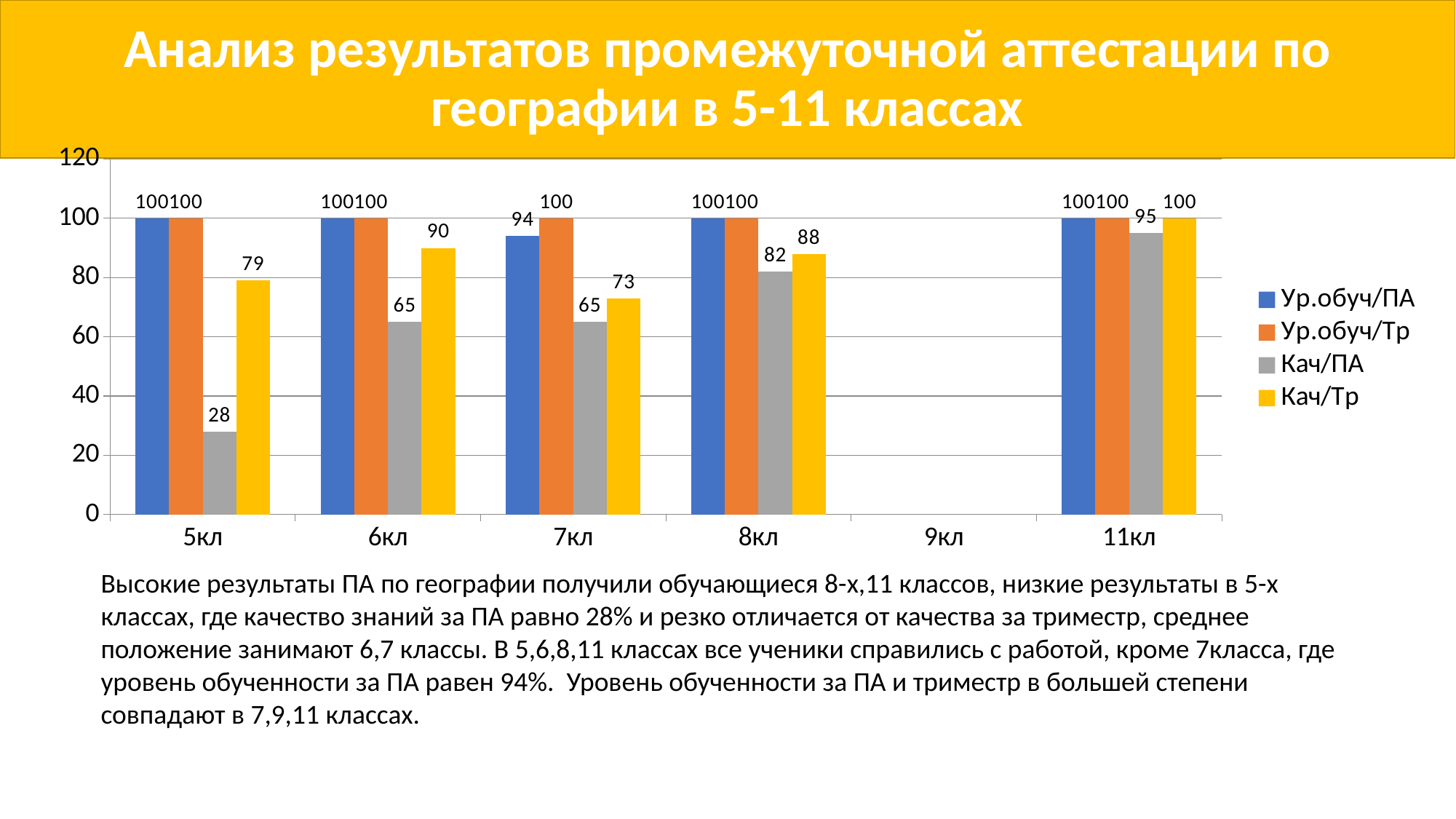
Which class category has no bars plotted? 9кл How many series does the legend list? 4 What is the value of Кач/ПА for 5кл? 28 Which class has the highest Кач/Тр value? 11кл What is the value of Кач/Тр for 6кл? 90 How many class categories are shown on the x axis? 6 What is the difference between Кач/Тр and Кач/ПА for 5кл? 51 Which is larger for 8кл: Кач/ПА or Кач/Тр? Кач/Тр Which class has the lowest Кач/ПА value? 5кл What kind of chart is shown on the slide? Bar chart What is the value of Ур.обуч/ПА for 7кл? 94 What is the value of Кач/ПА for 11кл? 95